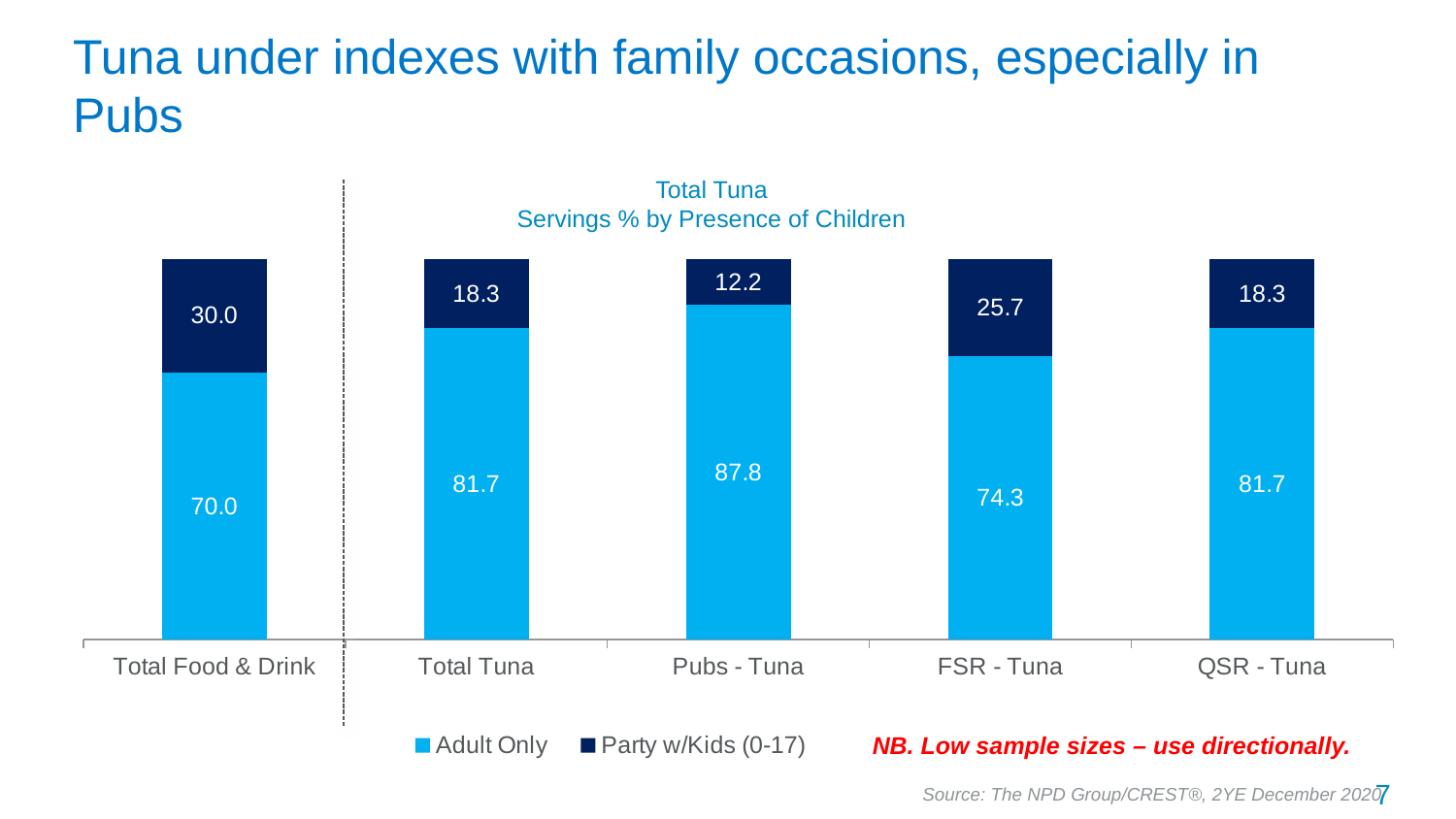
How many series does the legend list? 2 Which is larger, the Adult Only value for FSR - Tuna or for QSR - Tuna? QSR - Tuna What is the difference between the Party w/Kids (0-17) values for Total Food & Drink and Pubs - Tuna? 17.8 How many categories are shown on the x axis? 5 What kind of chart is shown? Stacked bar chart What is the total of the stacked bar for Total Tuna? 100.0 What is the Party w/Kids (0-17) value for Total Food & Drink? 30.0 What is the title of the chart? Total Tuna Servings % by Presence of Children What is the Party w/Kids (0-17) value for FSR - Tuna? 25.7 Which category has the highest Adult Only value? Pubs - Tuna What is the Adult Only value for Pubs - Tuna? 87.8 Which category has the lowest Party w/Kids (0-17) value? Pubs - Tuna